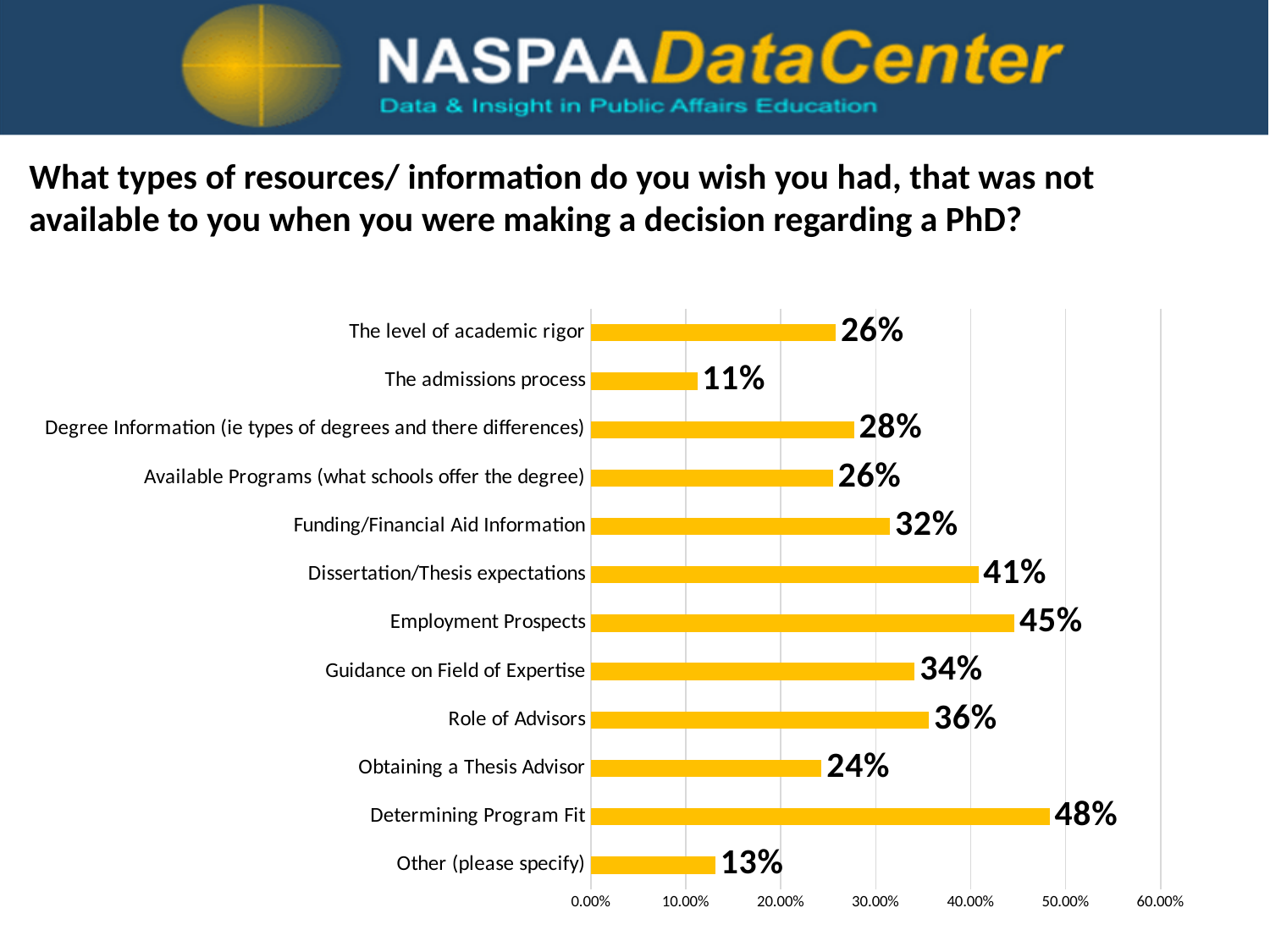
What is the value for Other (please specify)? 13% Which category has the highest value? Determining Program Fit Which category has the lowest value? The admissions process What kind of chart is shown on the slide? Bar chart What is the value for Funding/Financial Aid Information? 32% What is the difference between Employment Prospects and Dissertation/Thesis expectations? 4% Which is larger, Role of Advisors or Guidance on Field of Expertise? Role of Advisors What colour are the bars in the chart? Yellow How many categories are shown in the chart? 12 Is the value for Obtaining a Thesis Advisor greater or less than 30.00%? less What is the value for Determining Program Fit? 48% What is the value for The admissions process? 11%